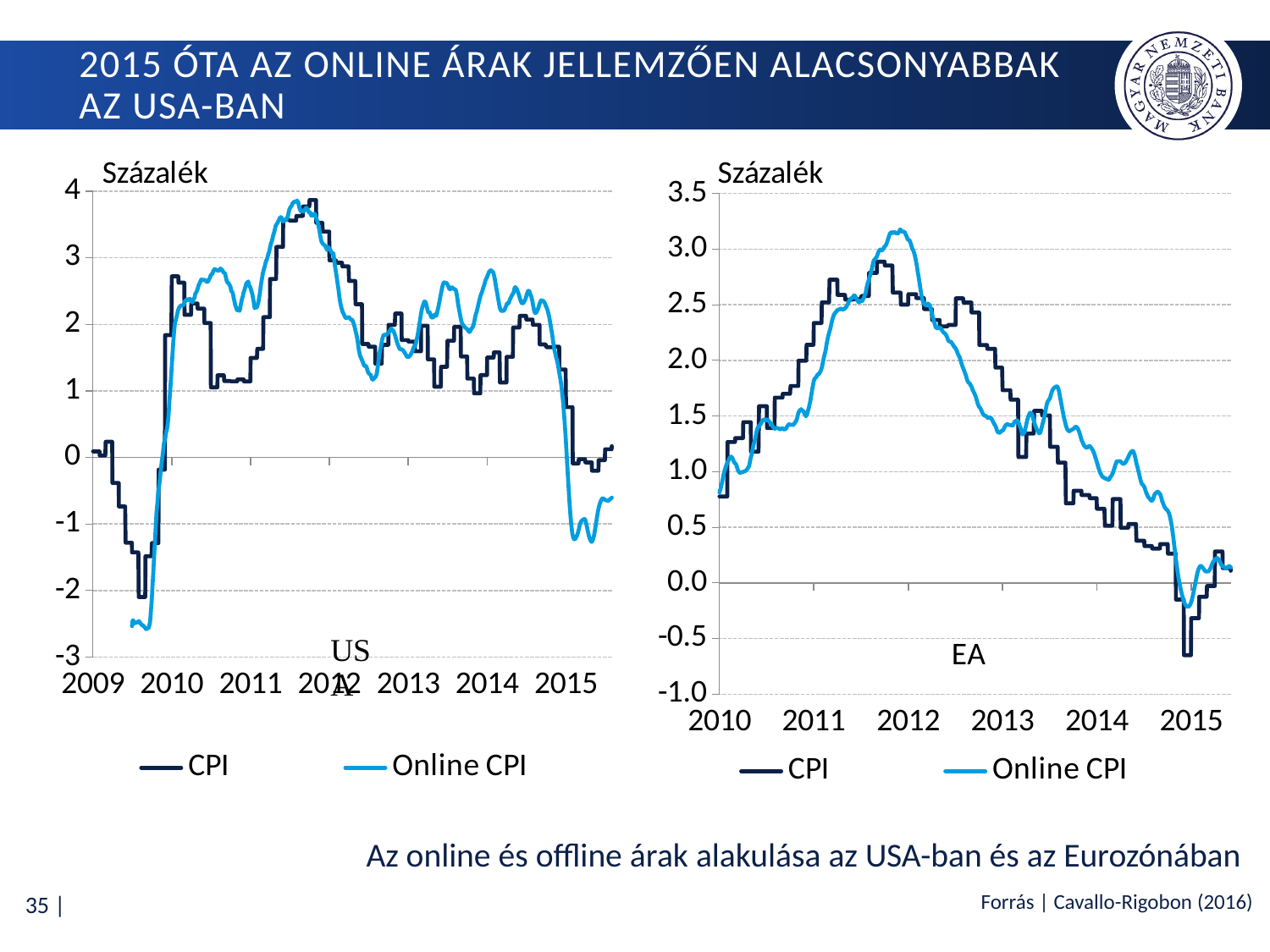
What kind of chart is the US chart on the left? line chart What unit label appears above the y axis of both charts? Százalék How many series does the legend of the EA chart list? 2 In the EA chart, is the lowest CPI value in 2015 greater or less than -0.5? less In the EA chart, is the CPI value at the start of 2010 greater or less than 1.0? less In the EA chart, which series reaches the higher peak around the start of 2012, CPI or Online CPI? Online CPI What are the two series named in the legend of the US chart? CPI and Online CPI In the EA chart, is the peak Online CPI value around the start of 2012 greater or less than 3.0? greater In the US chart, do the CPI values generally rise or fall between mid-2009 and late 2011? rise In the EA chart, do the CPI values generally rise or fall between 2012 and 2015? fall